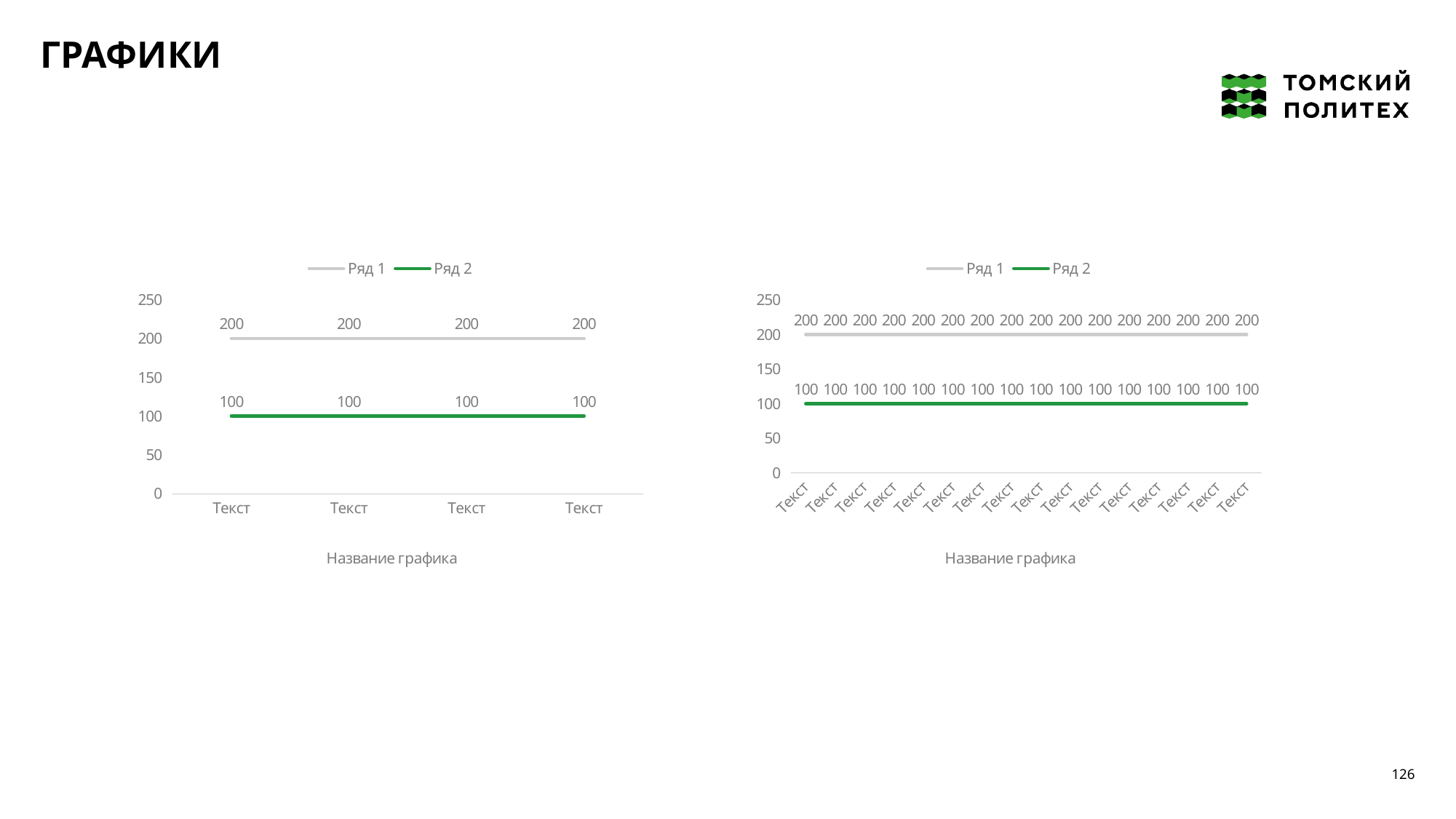
How many series does the legend of the left chart list? 2 What kind of chart is the chart on the right side of the slide? line chart In the right chart, which series has the higher values, Ряд 1 or Ряд 2? Ряд 1 What are the names of the two series in the legend of the right chart? Ряд 1 and Ряд 2 In the left chart, what is the difference between the Ряд 1 value and the Ряд 2 value at any category? 100 How many categories are shown on the x axis of the left chart? 4 In the right chart, do the values of Ряд 1 rise, fall or stay flat along the x axis? stay flat How many categories are shown on the x axis of the right chart? 16 In the left chart, what value does Ряд 1 have at each category? 200 What kind of chart is the chart on the left side of the slide? line chart In the left chart, what value does Ряд 2 have at each category? 100 In the right chart, what value does Ряд 2 have at each category? 100